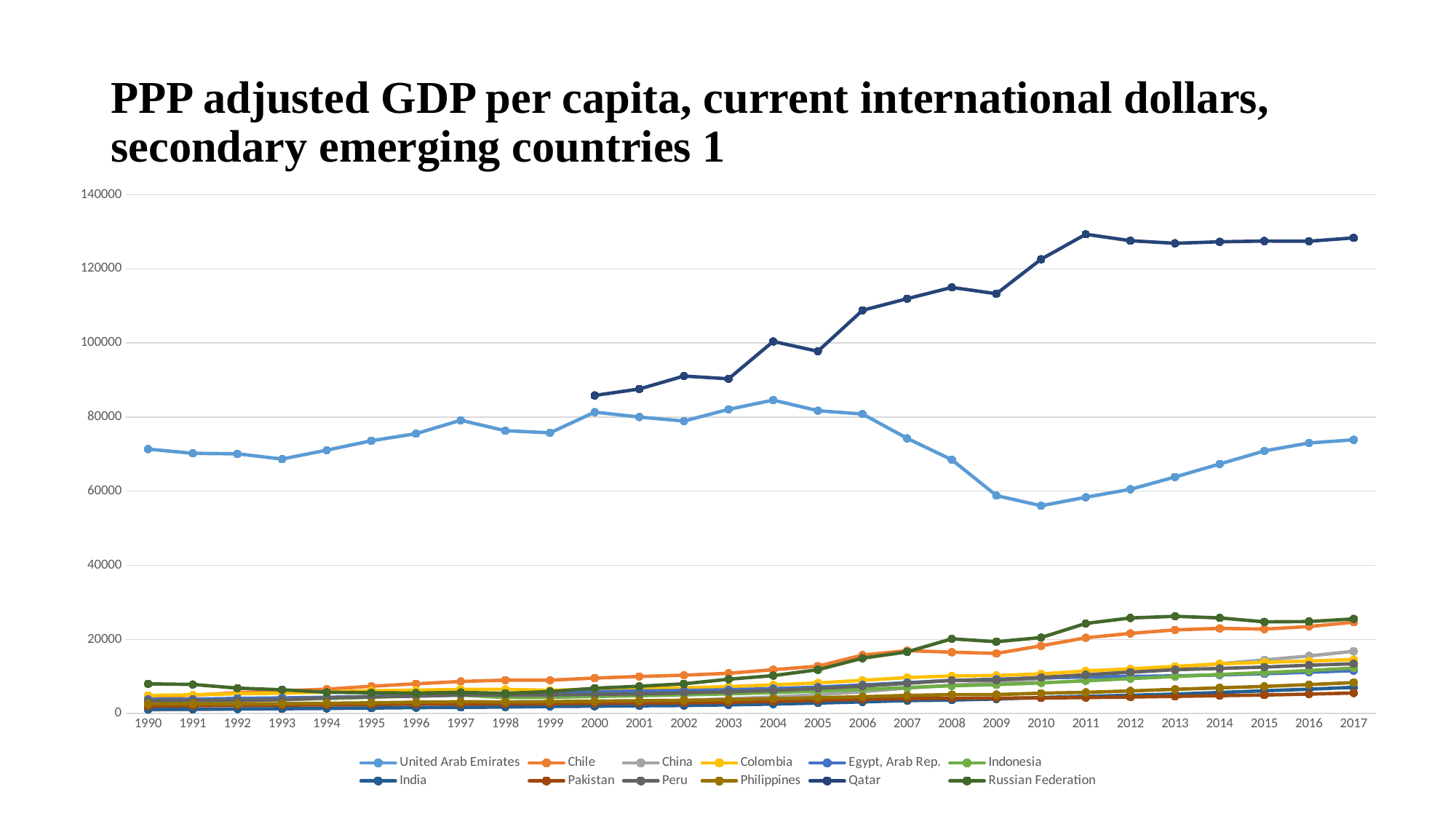
Does the United Arab Emirates line rise or fall from 2004 to 2010? fall Which is larger in 2017, the value for Qatar or the value for United Arab Emirates? Qatar In which year does the Qatar line first appear on the chart? 2000 Is the value for Qatar in 2011 greater or less than 120000? greater Is the value for United Arab Emirates in 2010 greater or less than 60000? less Is the value for Qatar in 2000 greater or less than 80000? greater Does the Qatar line rise or fall overall from 2000 to 2017? rise What kind of chart is shown on the slide? line chart How many series does the legend list? 12 Which country has the highest value in 2017? Qatar How many years are shown along the x axis? 28